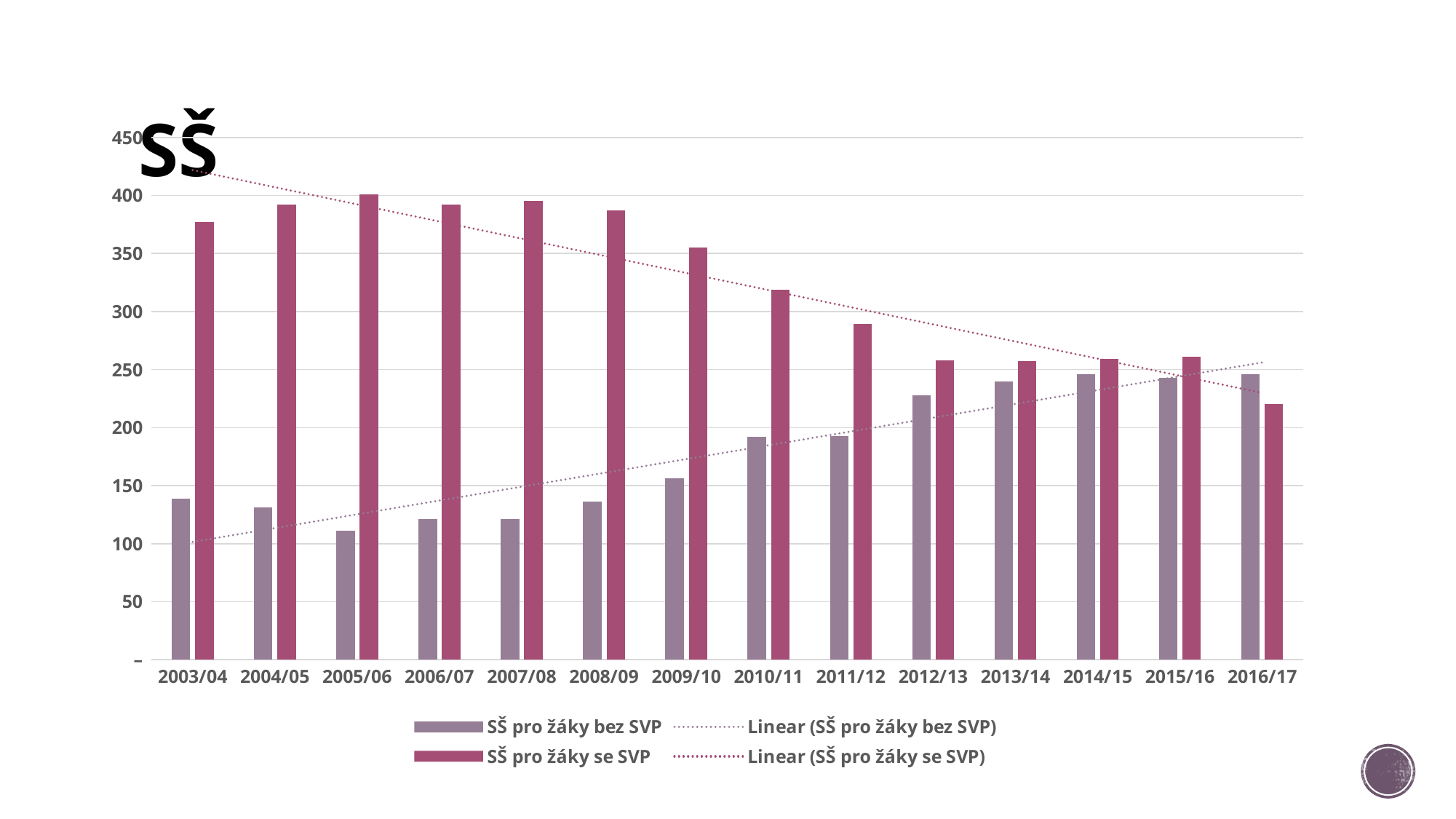
What kind of chart is shown on the slide? bar chart How many school years are shown on the x axis? 14 How many entries does the legend list? 4 Is the value for SŠ pro žáky bez SVP in 2012/13 greater or less than 200? greater In 2016/17, which series has the larger value: SŠ pro žáky bez SVP or SŠ pro žáky se SVP? SŠ pro žáky bez SVP In which school year is the value for SŠ pro žáky bez SVP lowest? 2005/06 Do the values for SŠ pro žáky se SVP generally rise or fall from 2003/04 to 2016/17? fall Is the value for SŠ pro žáky bez SVP in 2003/04 greater or less than 150? less Is the value for SŠ pro žáky se SVP in 2003/04 greater or less than 350? greater In which school year is the value for SŠ pro žáky se SVP lowest? 2016/17 What is the title of the chart? SŠ